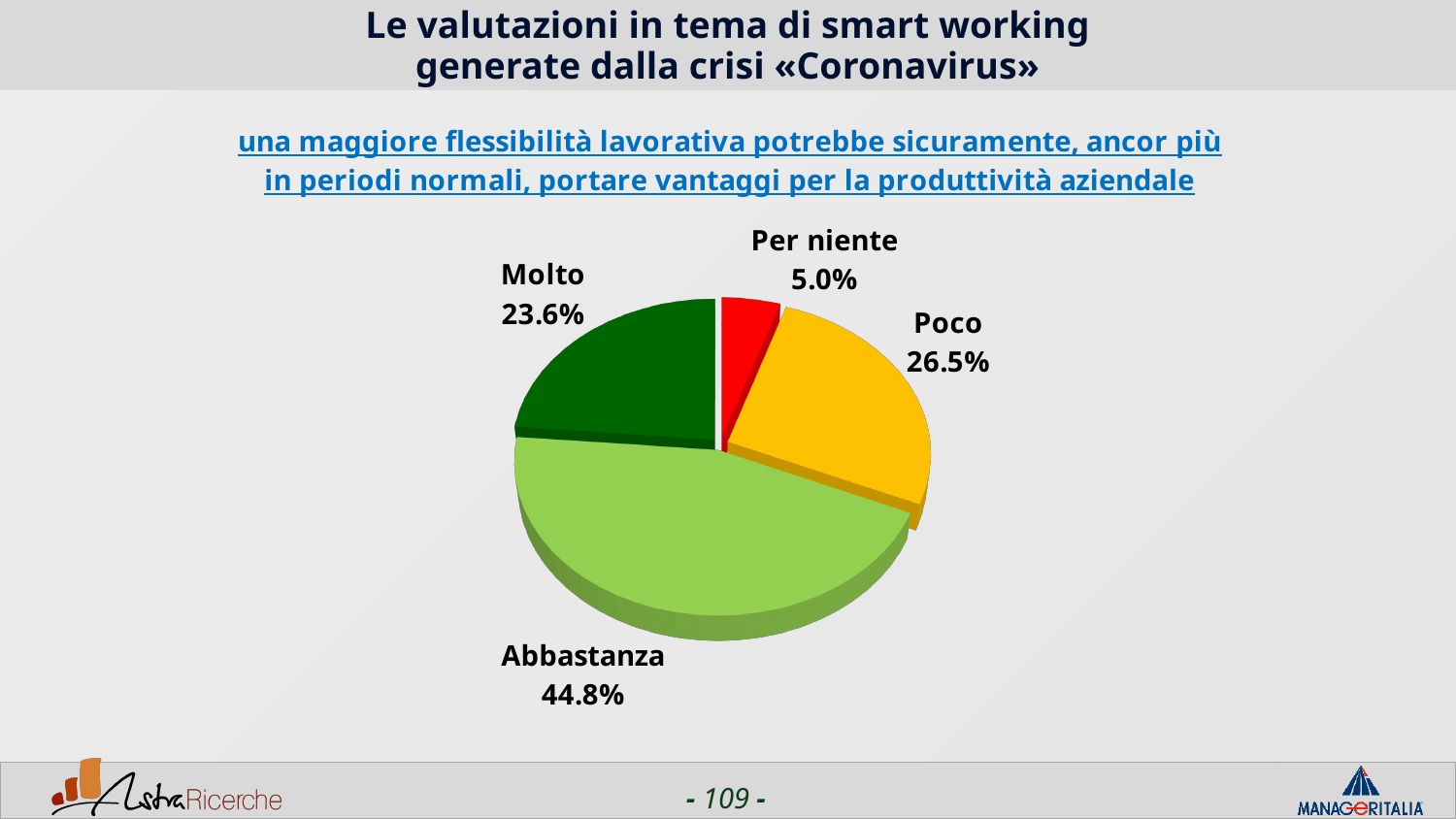
What is the value for "Per niente"? 5.0% Which category has the largest share of the pie? Abbastanza Which category has the smallest share of the pie? Per niente What is the value for "Abbastanza"? 44.8% What is the difference between the values for "Abbastanza" and "Poco"? 18.3% What is the combined share of "Molto" and "Abbastanza"? 68.4% What is the value for "Poco"? 26.5% Which is larger, the value for "Poco" or the value for "Molto"? Poco What colour is the slice for "Per niente"? red How many categories are shown in the pie chart? 4 What is the value for "Molto"? 23.6% What type of chart is shown on the slide? pie chart